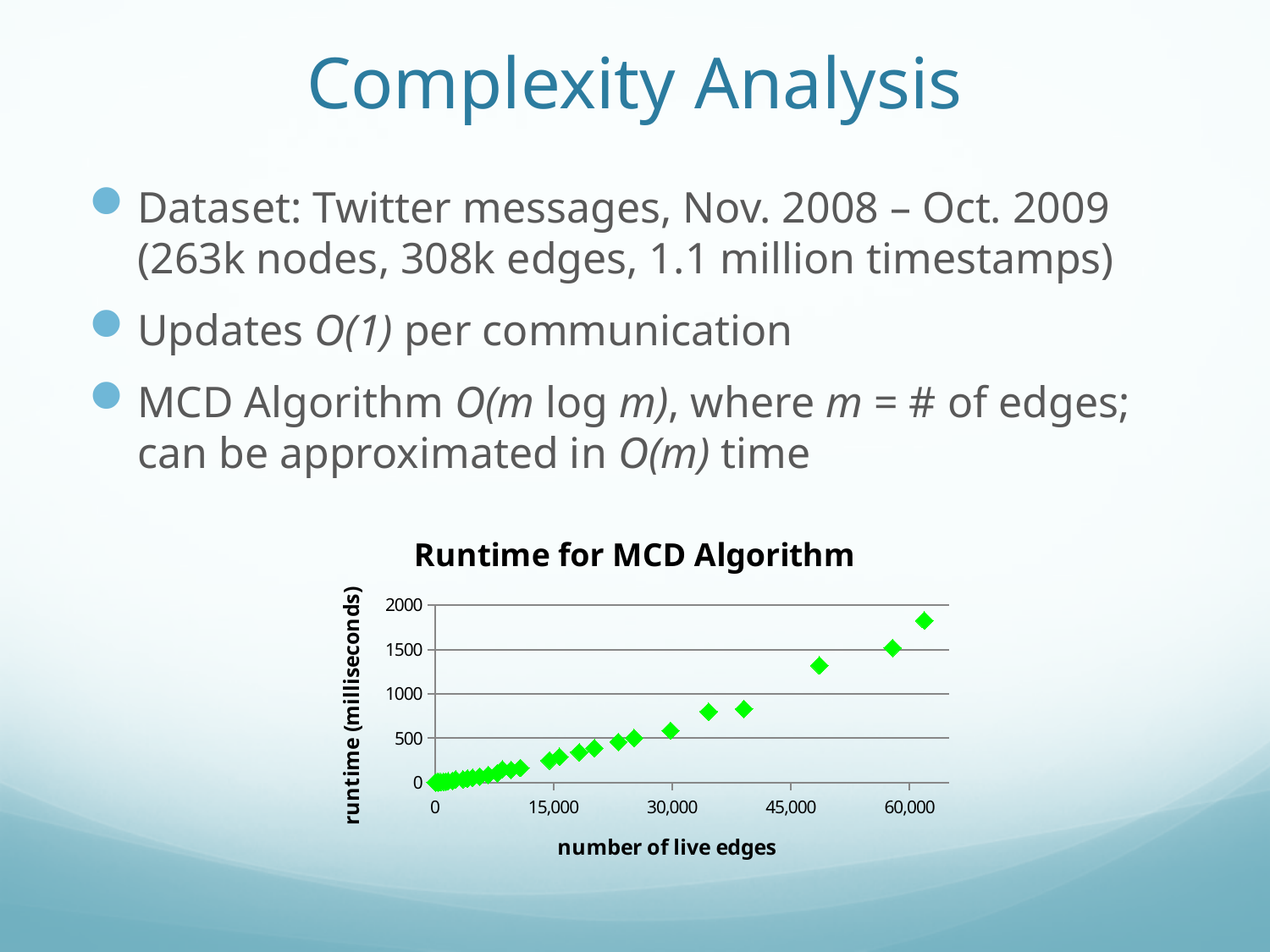
Is the runtime for the point at roughly 48,000 live edges greater or less than 1000 milliseconds? greater Is the runtime for the point at roughly 30,000 live edges greater or less than 1000 milliseconds? less What is the title of the chart? Runtime for MCD Algorithm Is the runtime for the point at roughly 48,000 live edges greater or less than 1500 milliseconds? less What is the label of the y axis of the chart? runtime (milliseconds) What kind of chart is shown on the slide? scatter plot Which has the higher runtime: the point near 48,000 live edges or the point near 30,000 live edges? the point near 48,000 live edges Does the runtime rise or fall as the number of live edges increases? rise What is the highest value shown on the y axis of the chart? 2000